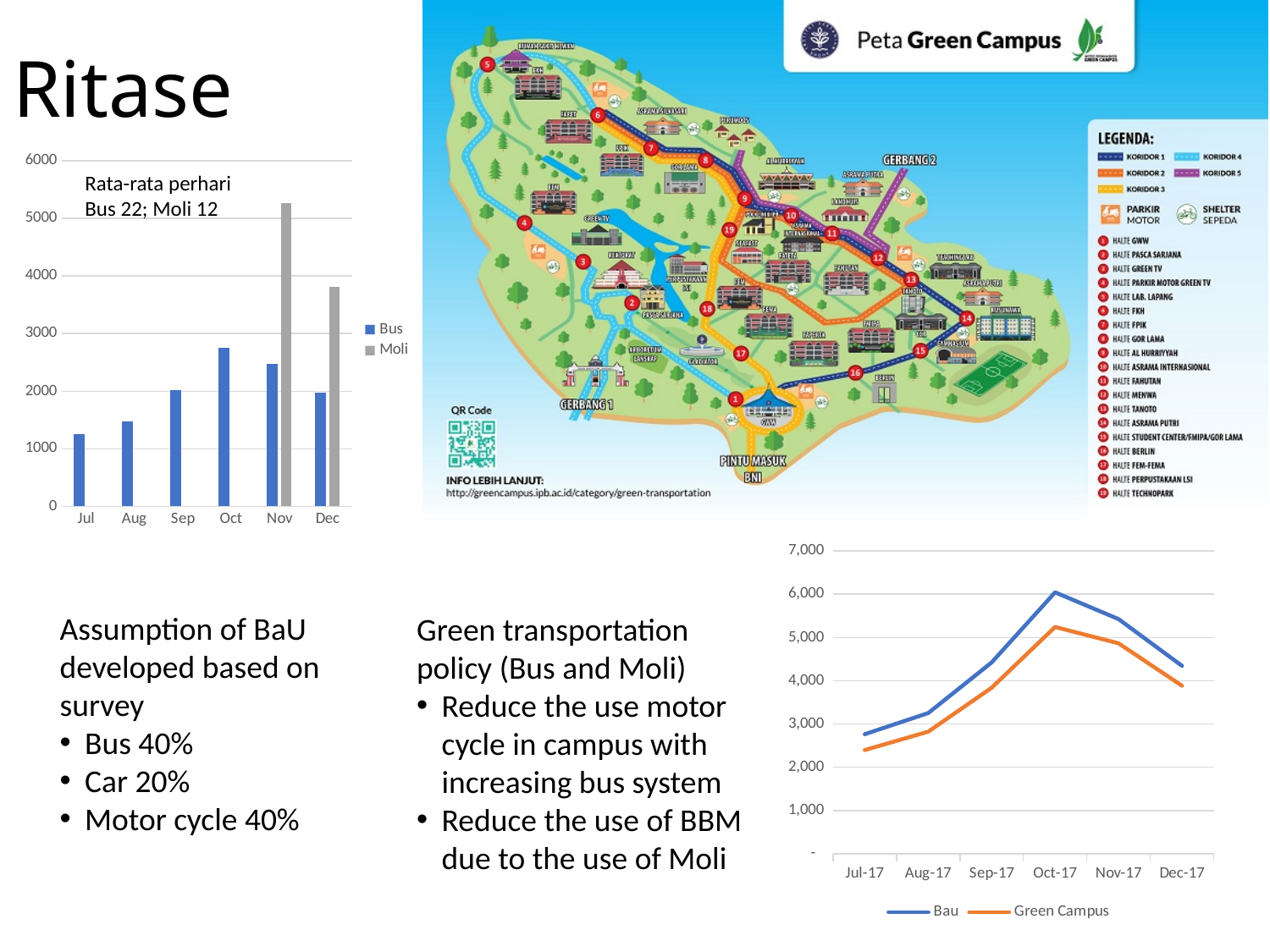
In the top-left bar chart, how many series does the legend list? 2 In the top-left bar chart, which month has the lowest Bus value? Jul In the top-left bar chart, is the Bus value for Oct greater or less than 3000? less What kind of chart is the top-left chart on the slide? bar chart In the top-left bar chart, which month has the highest Bus value? Oct In the bottom-right line chart, do the Bau values rise or fall from Jul-17 to Oct-17? rise In the bottom-right line chart, which month has the highest Bau value? Oct-17 In the bottom-right line chart, how many series does the legend list? 2 What kind of chart is the bottom-right chart on the slide? line chart In the top-left bar chart, how many months are shown on the x axis? 6 In the bottom-right line chart, is the Green Campus value for Jul-17 greater or less than 3,000? less In the top-left bar chart, is the Moli value for Nov greater or less than 5000? greater